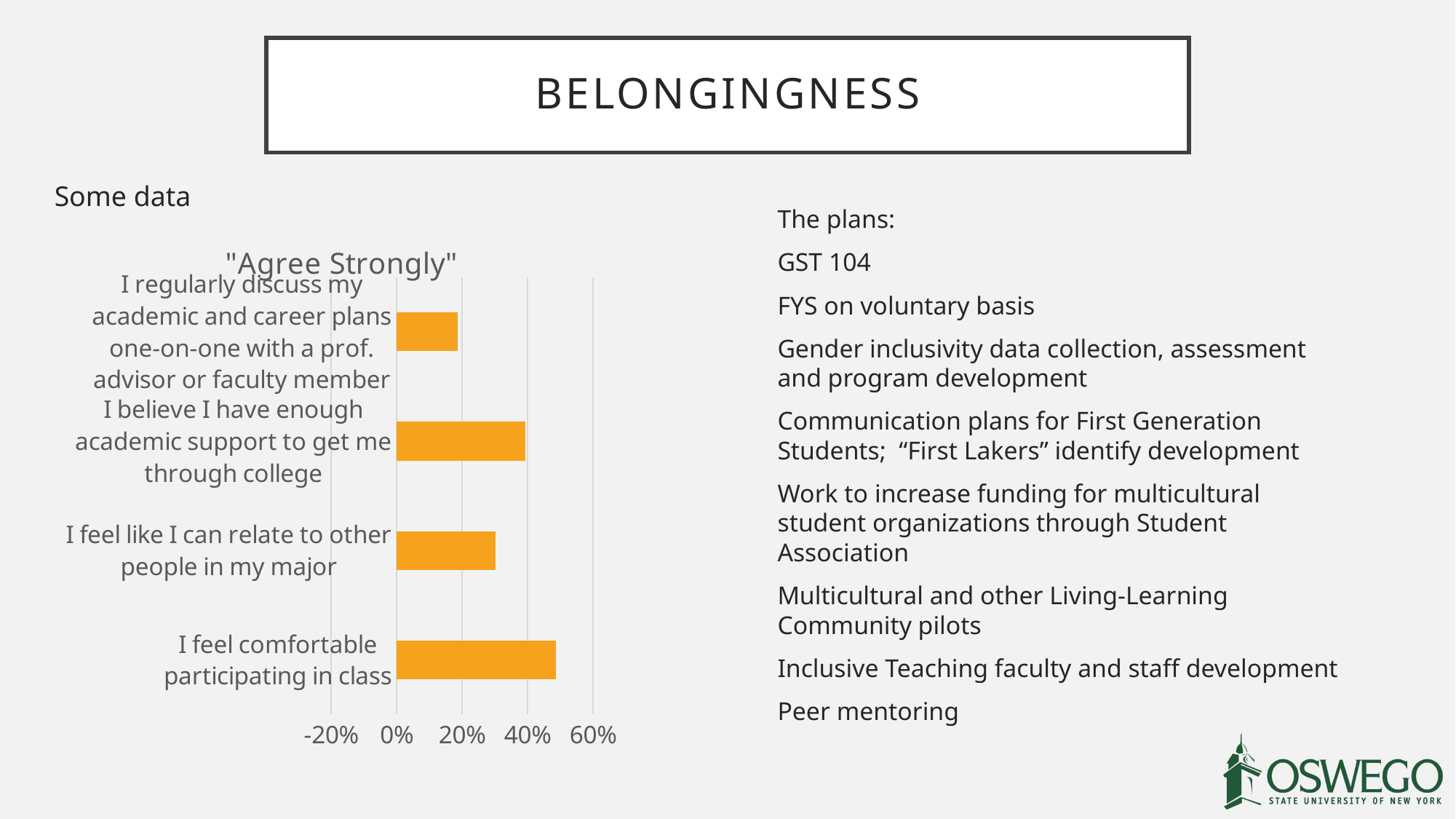
What colour are the bars in the chart? Orange Is the value for "I feel comfortable participating in class" greater or less than 40%? greater What is the title of the chart? "Agree Strongly" How many categories (survey statements) are plotted in the chart? 4 Which statement has the highest "Agree Strongly" value? I feel comfortable participating in class Is the value for "I feel like I can relate to other people in my major" greater or less than 20%? greater What kind of chart is shown on the slide? Bar chart Is the value for "I feel comfortable participating in class" greater or less than 60%? less Which is larger: the value for "I feel comfortable participating in class" or for "I regularly discuss my academic and career plans one-on-one with a prof. advisor or faculty member"? I feel comfortable participating in class Which is larger: the value for "I believe I have enough academic support to get me through college" or for "I feel like I can relate to other people in my major"? I believe I have enough academic support to get me through college Which statement has the lowest "Agree Strongly" value? I regularly discuss my academic and career plans one-on-one with a prof. advisor or faculty member